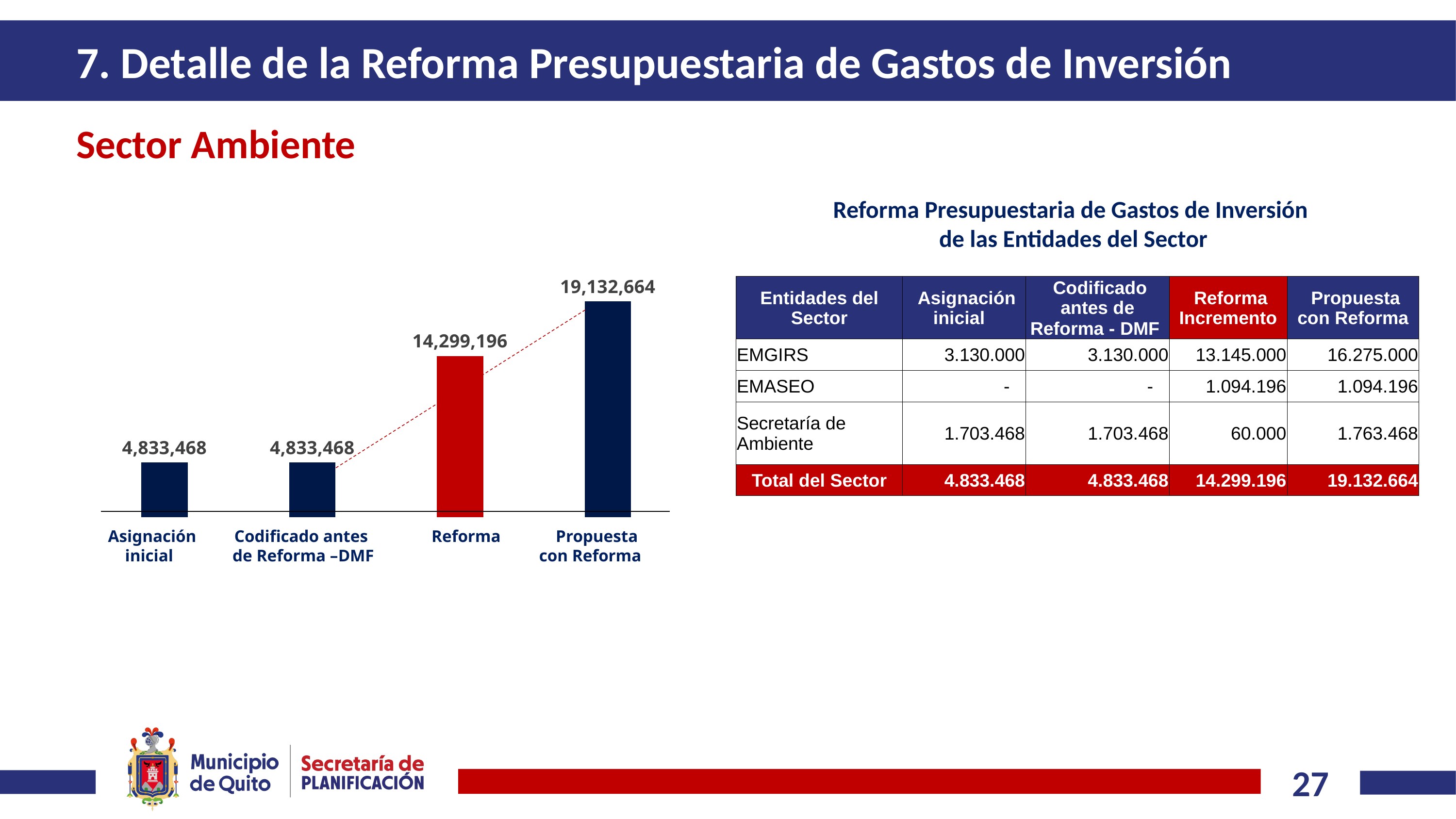
Which category has the highest value in the chart? Propuesta con Reforma What is the value of the Reforma bar? 14,299,196 Which is larger, the Reforma value or the Codificado antes de Reforma –DMF value? Reforma What colour is the Reforma bar? Red What type of chart is shown on the slide? Bar chart What is the value of the Codificado antes de Reforma –DMF bar? 4,833,468 What is the value of the Propuesta con Reforma bar? 19,132,664 What is the difference between the Reforma value and the Asignación inicial value? 9,465,728 Do the values rise or fall from Codificado antes de Reforma –DMF to Propuesta con Reforma? Rise How many bars are shown in the chart? 4 What is the difference between the Propuesta con Reforma value and the Reforma value? 4,833,468 What is the value of the Asignación inicial bar? 4,833,468